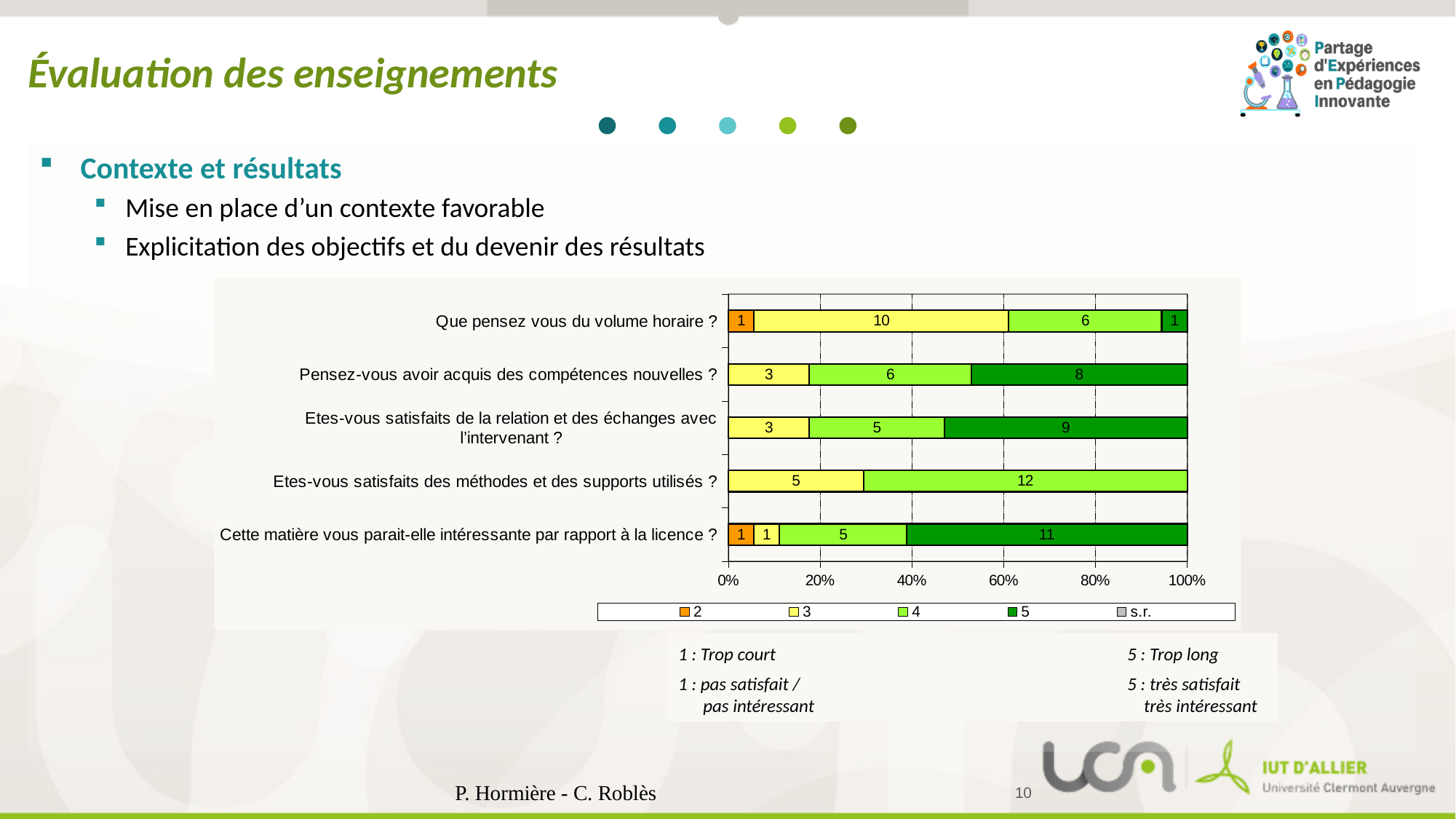
How many respondents answered 3 to "Que pensez vous du volume horaire ?"? 10 For "Pensez-vous avoir acquis des compétences nouvelles ?", which is larger: the value for series 4 or the value for series 5? Series 5 What is the value of series 4 for "Etes-vous satisfaits des méthodes et des supports utilisés ?"? 12 Which series in the legend is shown in orange? 2 What is the value of series 5 for "Cette matière vous parait-elle intéressante par rapport à la licence ?"? 11 How many series does the legend list? 5 What is the difference between the series 5 value and the series 3 value for "Etes-vous satisfaits de la relation et des échanges avec l'intervenant ?"? 6 What is the value of series 3 for "Etes-vous satisfaits de la relation et des échanges avec l'intervenant ?"? 3 What is the value of series 5 for "Pensez-vous avoir acquis des compétences nouvelles ?"? 8 How many question categories are shown on the chart? 5 What is the total number of responses in the bar for "Que pensez vous du volume horaire ?"? 18 What kind of chart is shown on the slide? Stacked bar chart